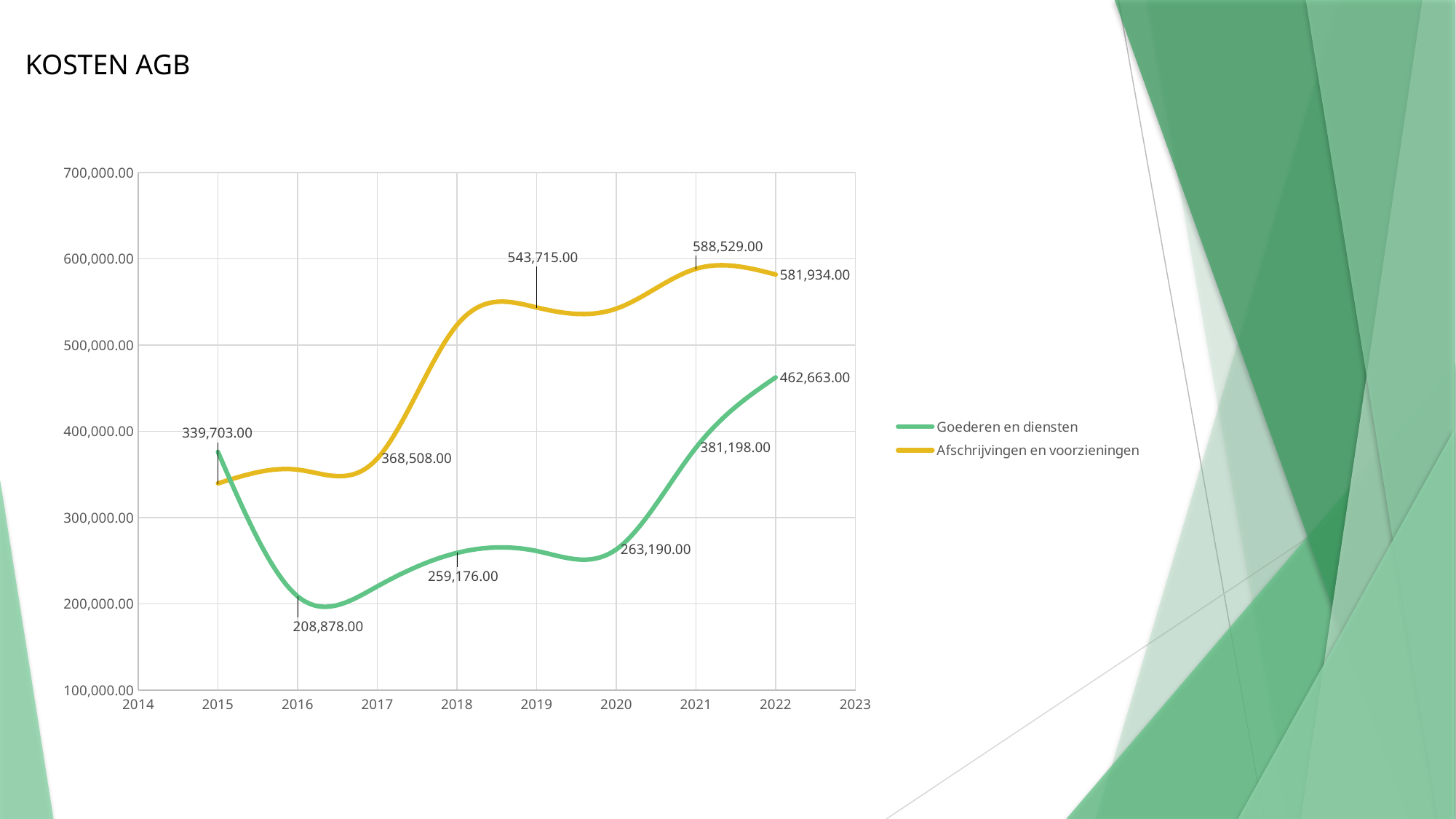
In which year does Afschrijvingen en voorzieningen reach its highest value? 2021 By how much did Goederen en diensten increase from 2021 to 2022? 81,465.00 What is the value for Goederen en diensten in 2016? 208,878.00 What is the title of the slide? KOSTEN AGB In 2022, what is the difference between Afschrijvingen en voorzieningen and Goederen en diensten? 119,271.00 What kind of chart is shown on the slide? line chart What is the value for Afschrijvingen en voorzieningen in 2019? 543,715.00 In 2021, which series has the higher value? Afschrijvingen en voorzieningen What is the value for Afschrijvingen en voorzieningen in 2021? 588,529.00 What is the value for Goederen en diensten in 2022? 462,663.00 Is the value for Goederen en diensten in 2017 greater or less than 300,000.00? less How many series does the legend list? 2